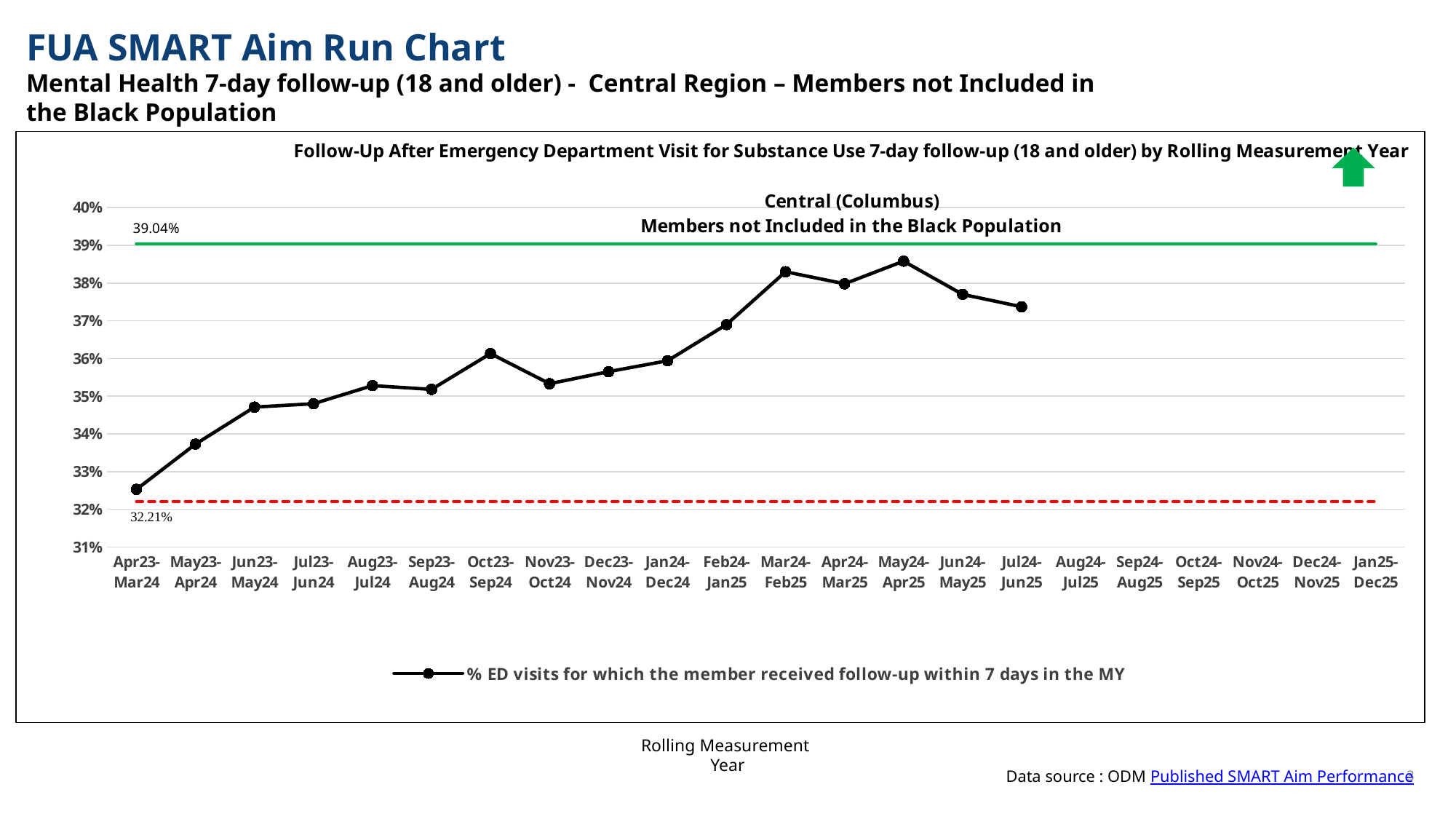
Is the value for Apr23-Mar24 greater or less than 33%? less What value is labelled on the solid green horizontal line? 39.04% How many series does the legend list? 1 Overall, do the plotted values rise or fall from Apr23-Mar24 to Jul24-Jun25? rise Which rolling measurement year has the highest plotted value? May24-Apr25 What value is labelled on the red dashed horizontal line? 32.21% Is the value for Jun23-May24 greater or less than 34%? greater How many data points are plotted on the line? 16 Which rolling measurement year has the lowest plotted value? Apr23-Mar24 What kind of chart is shown on the slide? line chart Which is larger, the value for Oct23-Sep24 or the value for Nov23-Oct24? Oct23-Sep24 Is the value for Jul24-Jun25 greater or less than 37%? greater